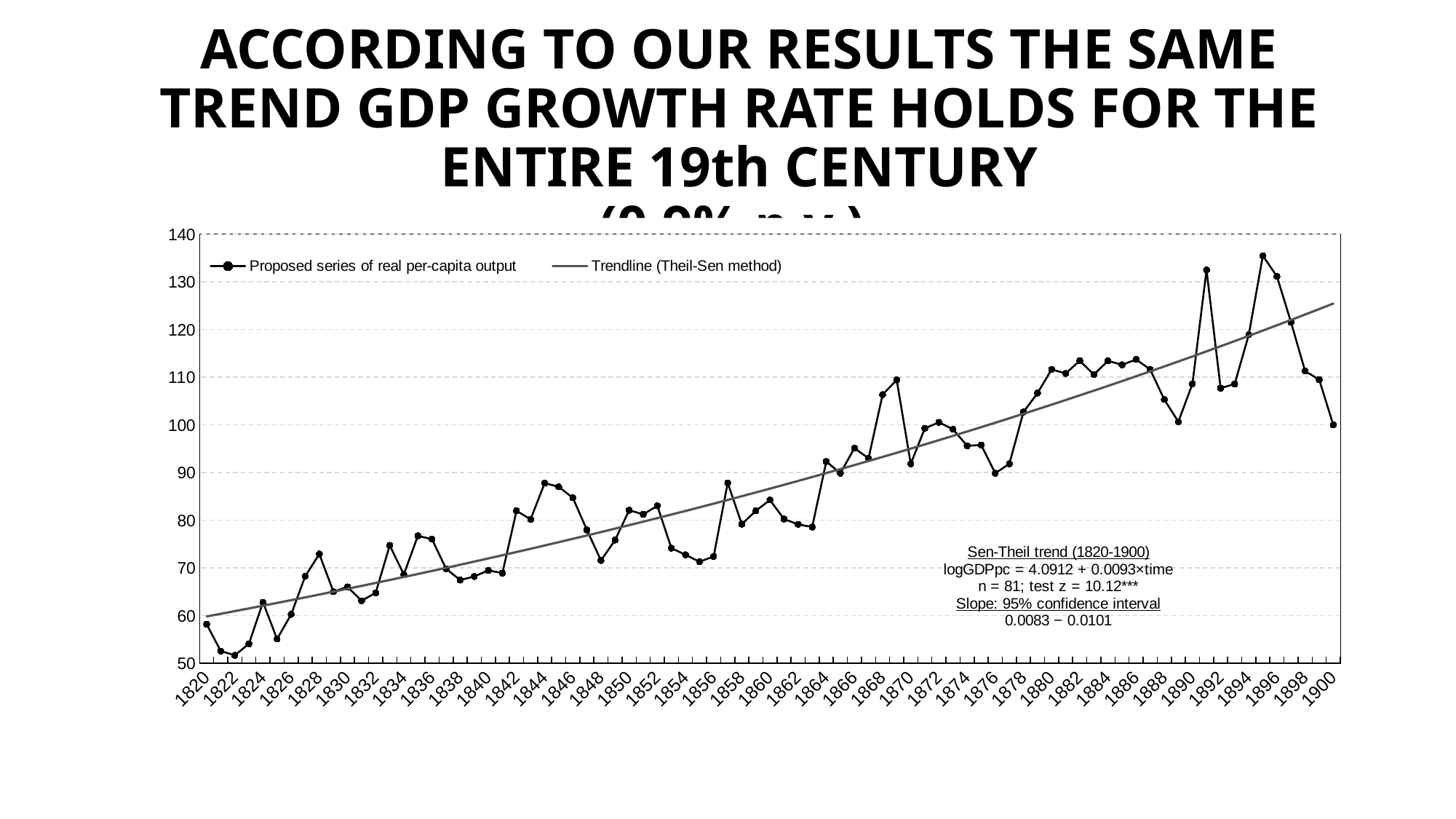
Is the value of the proposed series of real per-capita output for 1876 greater or less than 100? less Is the value of the proposed series of real per-capita output for 1895 greater or less than 130? greater Do the values of the proposed series of real per-capita output generally rise or fall from 1820 to 1900? rise Is the value of the proposed series of real per-capita output for 1844 greater or less than 80? greater Which is larger, the proposed series value for 1876 or for 1891? 1891 Which year has the highest value of the proposed series of real per-capita output? 1895 How many series does the legend list? 2 Which year has the lowest value of the proposed series of real per-capita output? 1822 What is the name of the second series in the legend? Trendline (Theil-Sen method) What kind of chart is shown on the slide? line chart According to the Sen-Theil trend annotation on the chart, what is n? 81